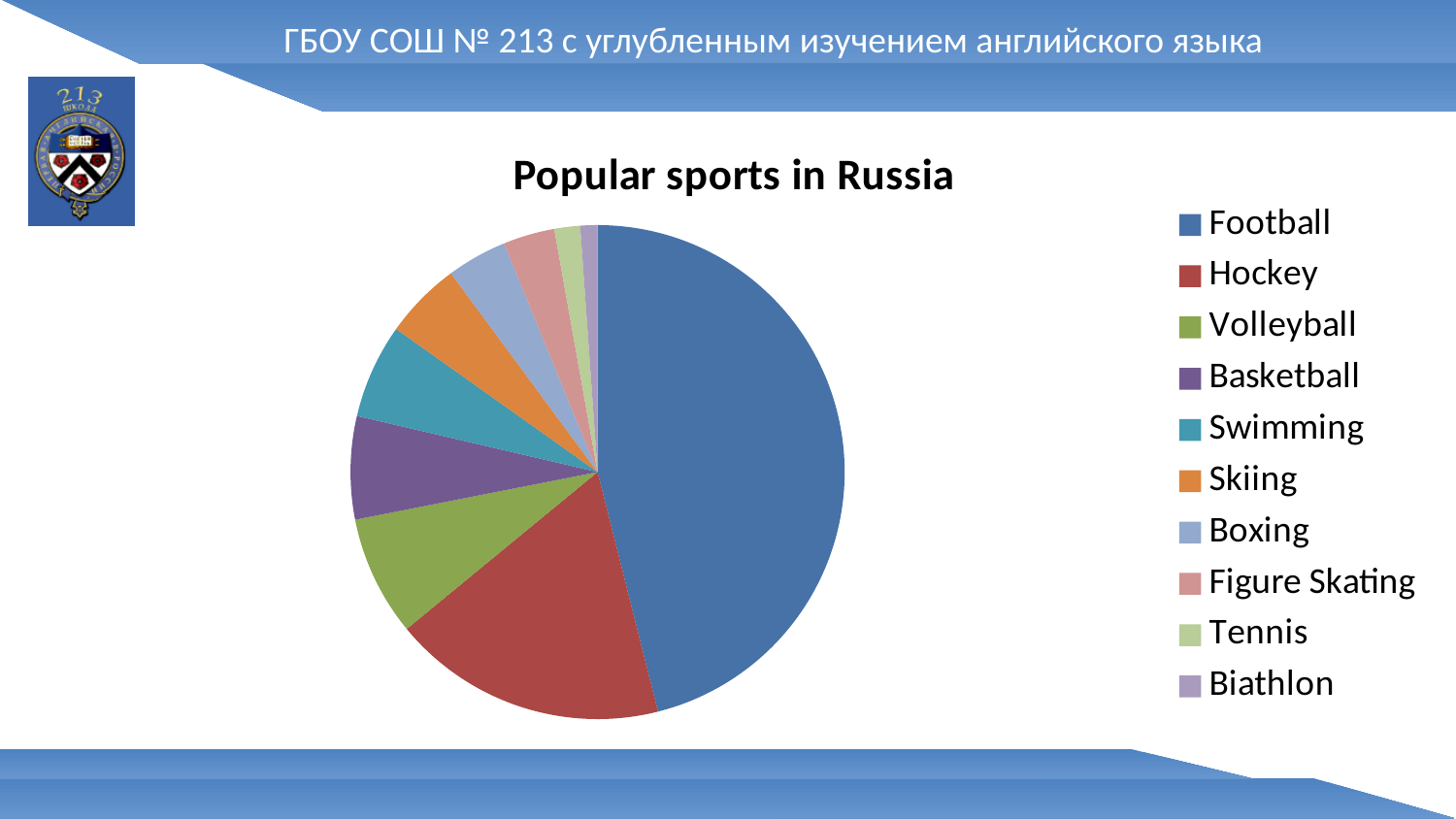
What is the title of the chart? Popular sports in Russia Which slice is larger, Volleyball or Boxing? Volleyball Which sport has the largest slice of the pie? Football Which sport is listed last in the legend? Biathlon Which slice is larger, Football or Hockey? Football How many sports (slices) does the pie chart show? 10 What kind of chart is shown on the slide? pie chart Which slice is larger, Hockey or Volleyball? Hockey